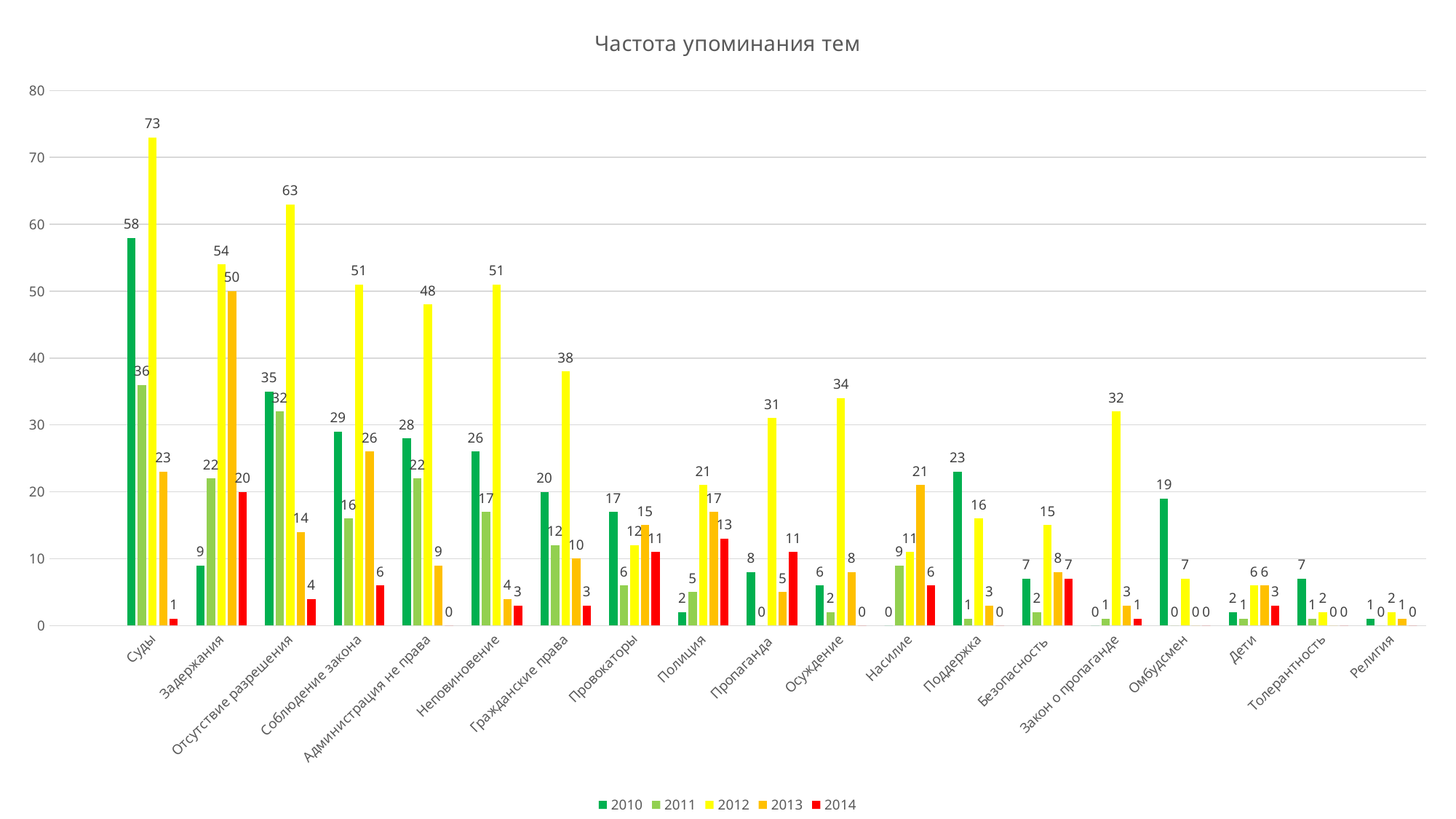
What is the value for 2013 in the Задержания category? 50 How many series does the legend list? 5 What kind of chart is shown on the slide? Bar chart What is the value for 2010 in the Омбудсмен category? 19 Which category has the highest value for the 2012 series? Суды In the Провокаторы category, which is larger: the value for 2010 or the value for 2012? 2010 What is the title of the chart? Частота упоминания тем Is the value for 2012 in the Администрация не права category greater or less than 40? greater How many categories are shown on the x axis? 19 Which series has the lowest value in the Суды category? 2014 What is the difference between the 2012 and 2010 values in the Отсутствие разрешения category? 28 What is the value for 2012 in the Суды category? 73